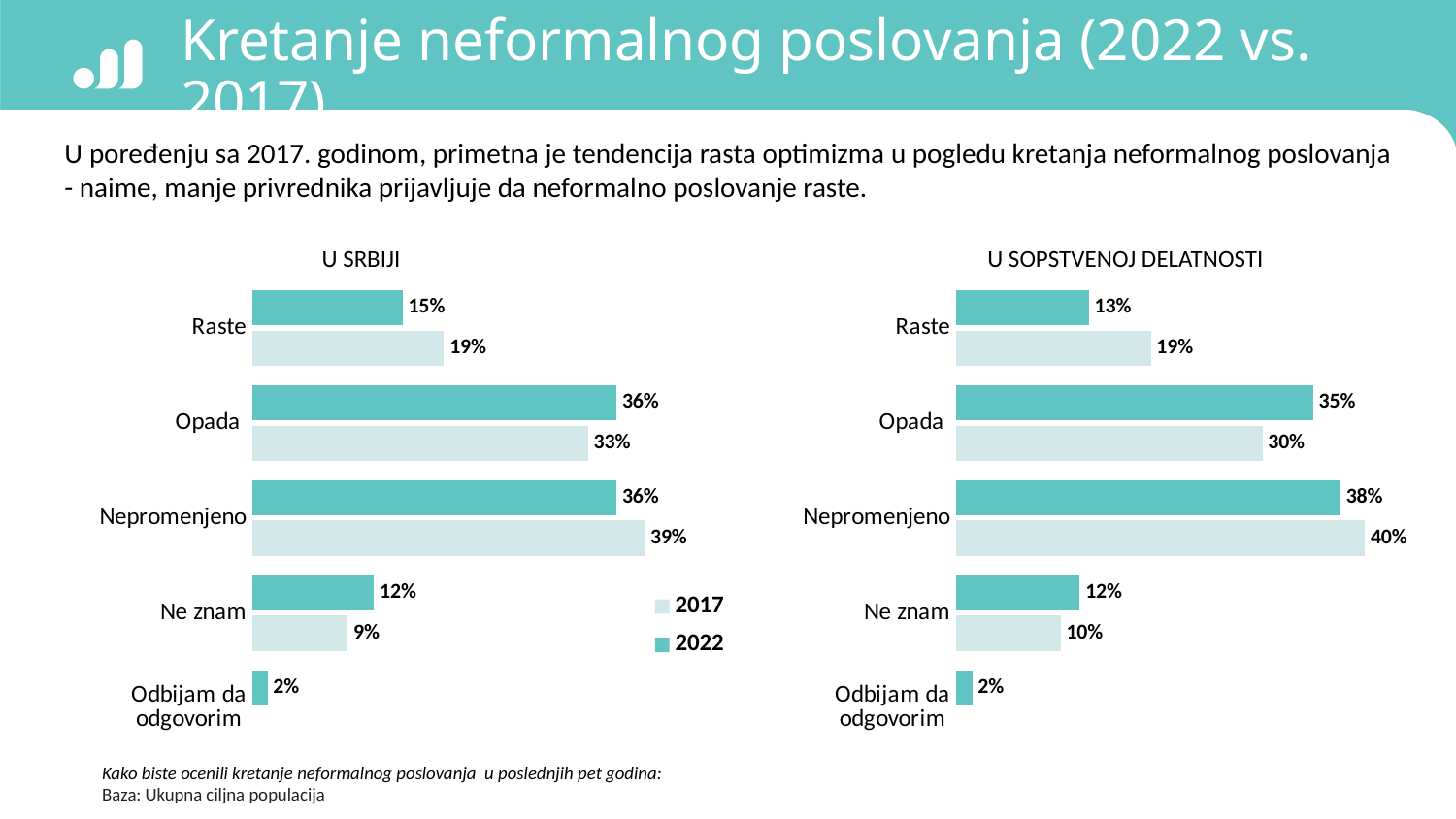
In the 'U SOPSTVENOJ DELATNOSTI' chart, which category has the lowest 2017 value? Ne znam What kind of chart is the 'U SOPSTVENOJ DELATNOSTI' chart? bar chart In the 'U SOPSTVENOJ DELATNOSTI' chart, what is the difference between the 2022 and 2017 values for Opada? 5% In the 'U SOPSTVENOJ DELATNOSTI' chart, what is the 2022 value for Ne znam? 12% In the 'U SRBIJI' chart, what is the 2022 value for Raste? 15% In the 'U SRBIJI' chart, which category has the highest 2017 value? Nepromenjeno In the 'U SRBIJI' chart, is the 2022 value for Ne znam larger or smaller than the 2017 value for Ne znam? larger How many series does the legend list on the slide? 2 In the 'U SRBIJI' chart, what is the difference between the 2017 and 2022 values for Raste? 4% In the 'U SOPSTVENOJ DELATNOSTI' chart, which category has the highest 2022 value? Nepromenjeno In the 'U SOPSTVENOJ DELATNOSTI' chart, what is the 2017 value for Opada? 30% In the 'U SRBIJI' chart, what is the 2017 value for Nepromenjeno? 39%